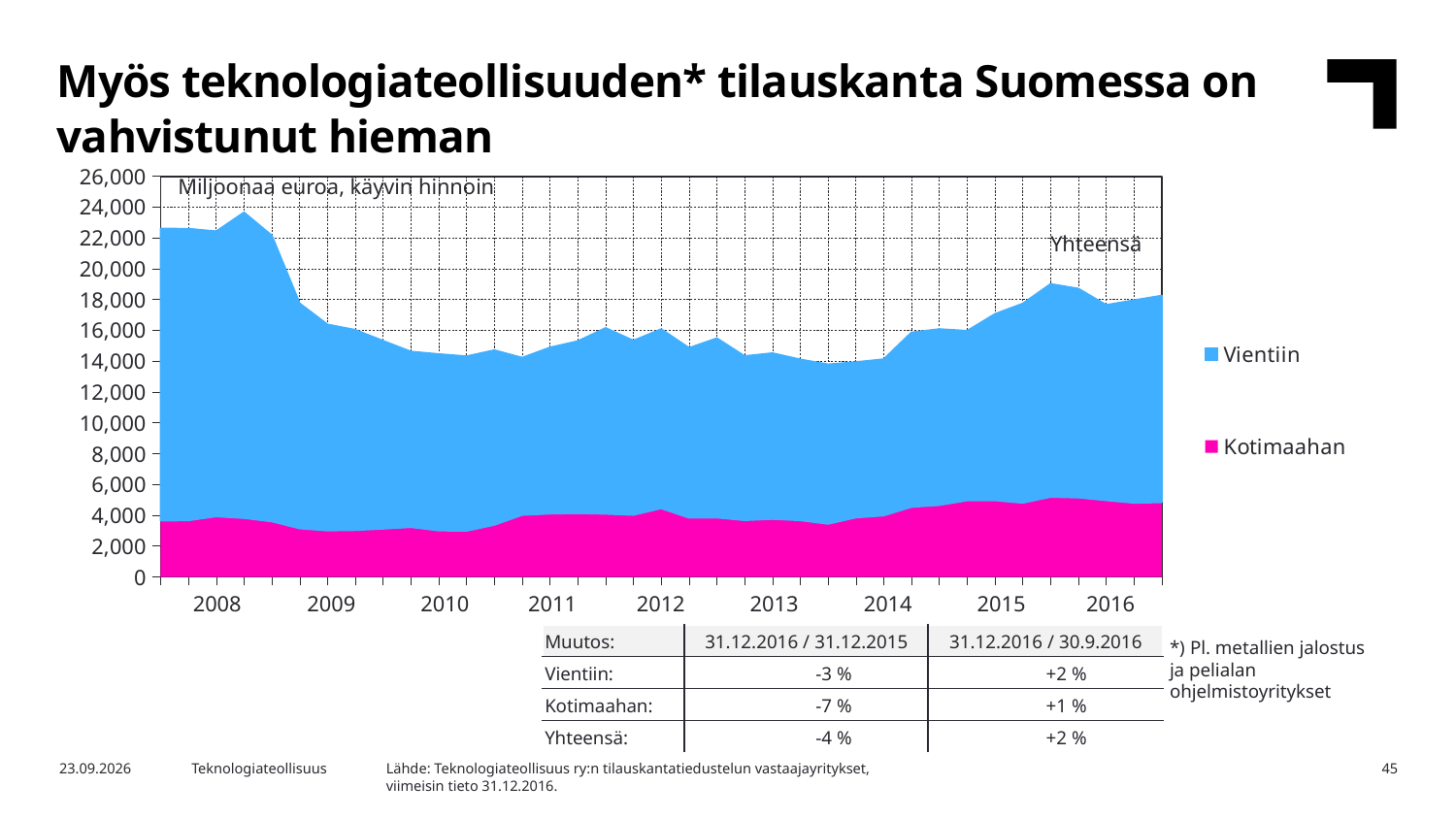
What are the two series named in the chart legend? Vientiin and Kotimaahan What unit label is printed inside the chart area? Miljoonaa euroa, käyvin hinnoin How many series does the chart legend list? 2 What kind of chart is shown on the slide? Area chart Which series, Vientiin or Kotimaahan, has the larger values throughout the chart? Vientiin Is the Kotimaahan value at the end of 2016 greater or less than 4,000? greater In which year does the total (Yhteensä) reach its highest level on the chart? 2008 Does the total order book (Yhteensä) rise or fall between 2008 and 2010? fall Is the total (Yhteensä) value at the start of 2008 greater or less than 20,000? greater Is the Kotimaahan value in 2010 greater or less than 4,000? less How many years are labelled on the x axis of the chart? 9